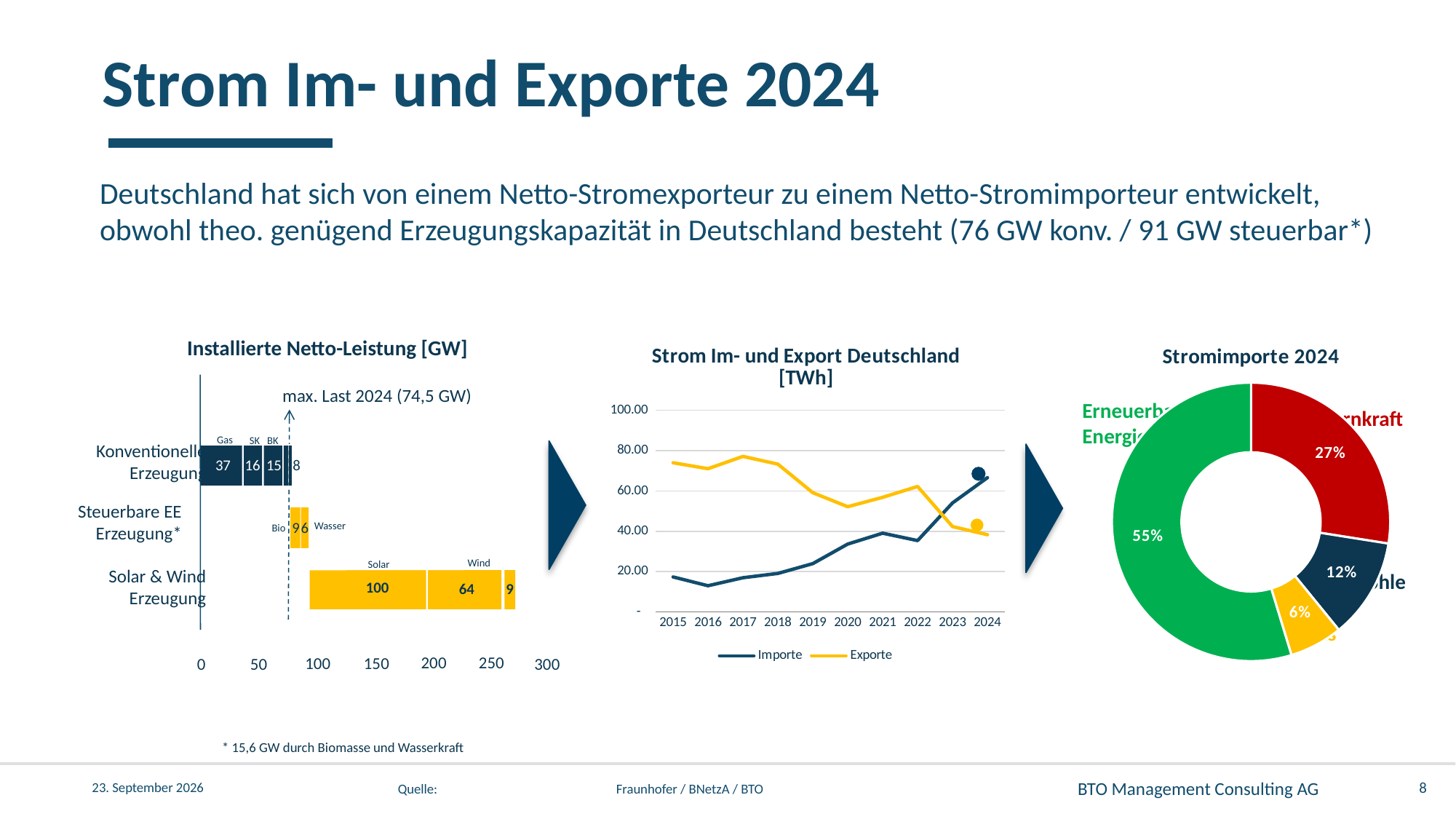
In the 'Installierte Netto-Leistung [GW]' chart, what is the total of the Konventionelle Erzeugung bar (37 + 16 + 15 + 8)? 76 In the 'Strom Im- und Export Deutschland [TWh]' chart, do the Importe values generally rise or fall from 2015 to 2024? Rise What kind of chart is the 'Strom Im- und Export Deutschland [TWh]' chart in the middle? Line chart In the 'Strom Im- und Export Deutschland [TWh]' chart, is the Importe value for 2024 greater or less than 60.00? greater In the 'Installierte Netto-Leistung [GW]' chart, what is the difference between the Solar segment and the Wind segment? 36 What kind of chart is the 'Installierte Netto-Leistung [GW]' chart on the left? Bar chart In the 'Stromimporte 2024' chart, what is the share of the largest slice? 55% In the 'Installierte Netto-Leistung [GW]' chart, what is the value of the Solar segment in the Solar & Wind Erzeugung bar? 100 How many series does the legend of the 'Strom Im- und Export Deutschland [TWh]' chart list? 2 How many years are shown on the x axis of the 'Strom Im- und Export Deutschland [TWh]' chart? 10 In the 'Installierte Netto-Leistung [GW]' chart, what is the value of the Gas segment in the Konventionelle Erzeugung bar? 37 In the 'Stromimporte 2024' chart, what is the share of the smallest slice? 6%